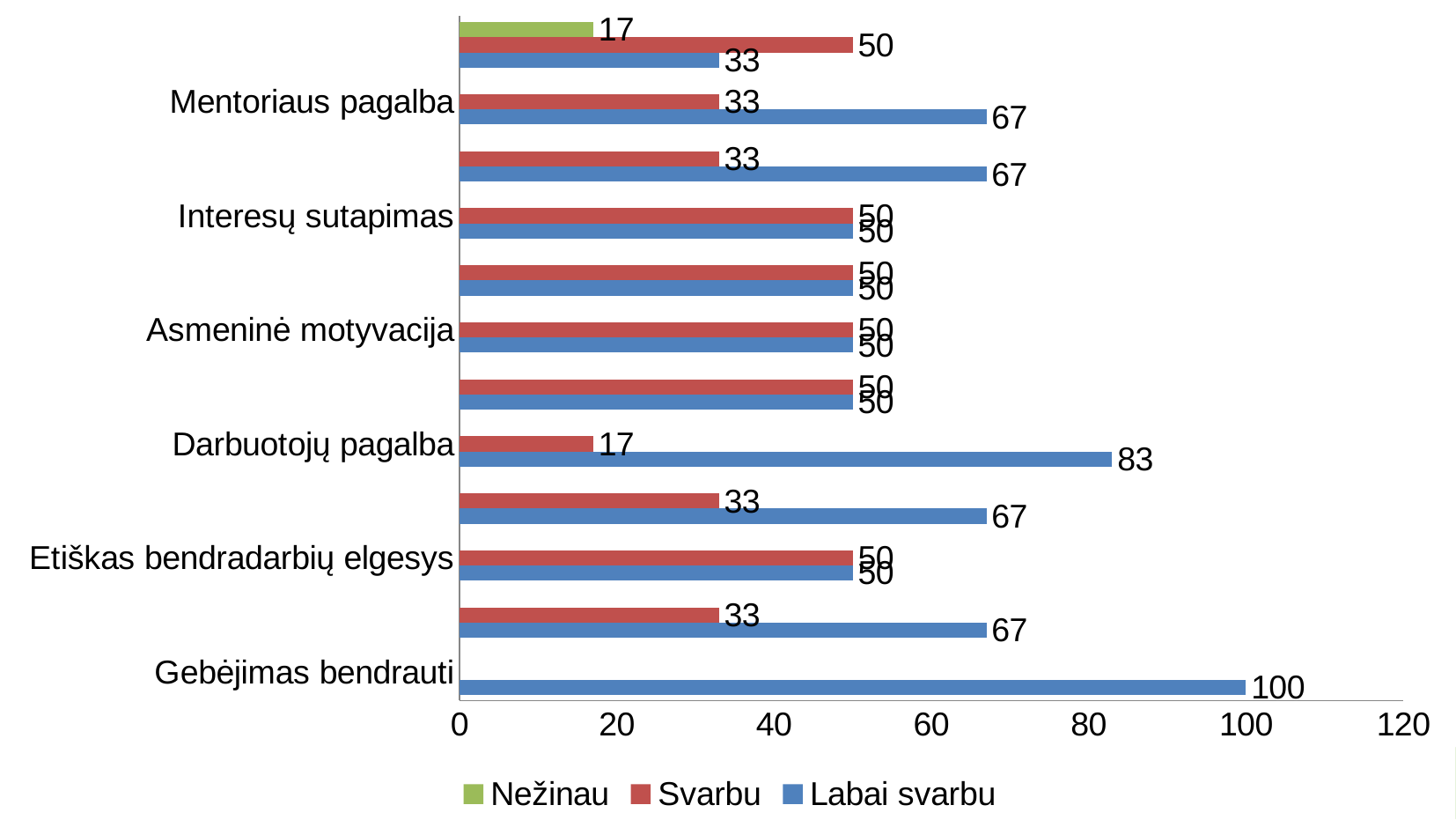
Which labelled category has the highest Labai svarbu value? Gebėjimas bendrauti What is the Labai svarbu value for Gebėjimas bendrauti? 100 What is the Svarbu value for Mentoriaus pagalba? 33 For Mentoriaus pagalba, which is larger: the Svarbu value or the Labai svarbu value? Labai svarbu What is the difference between the Labai svarbu and Svarbu values for Darbuotojų pagalba? 66 Which series is shown in green in the legend? Nežinau Is the Labai svarbu value for Darbuotojų pagalba greater or less than 80? greater What is the Labai svarbu value for Interesų sutapimas? 50 What kind of chart is shown on the slide? bar chart How many series does the legend list? 3 What is the Labai svarbu value for Darbuotojų pagalba? 83 What is the Svarbu value for Darbuotojų pagalba? 17